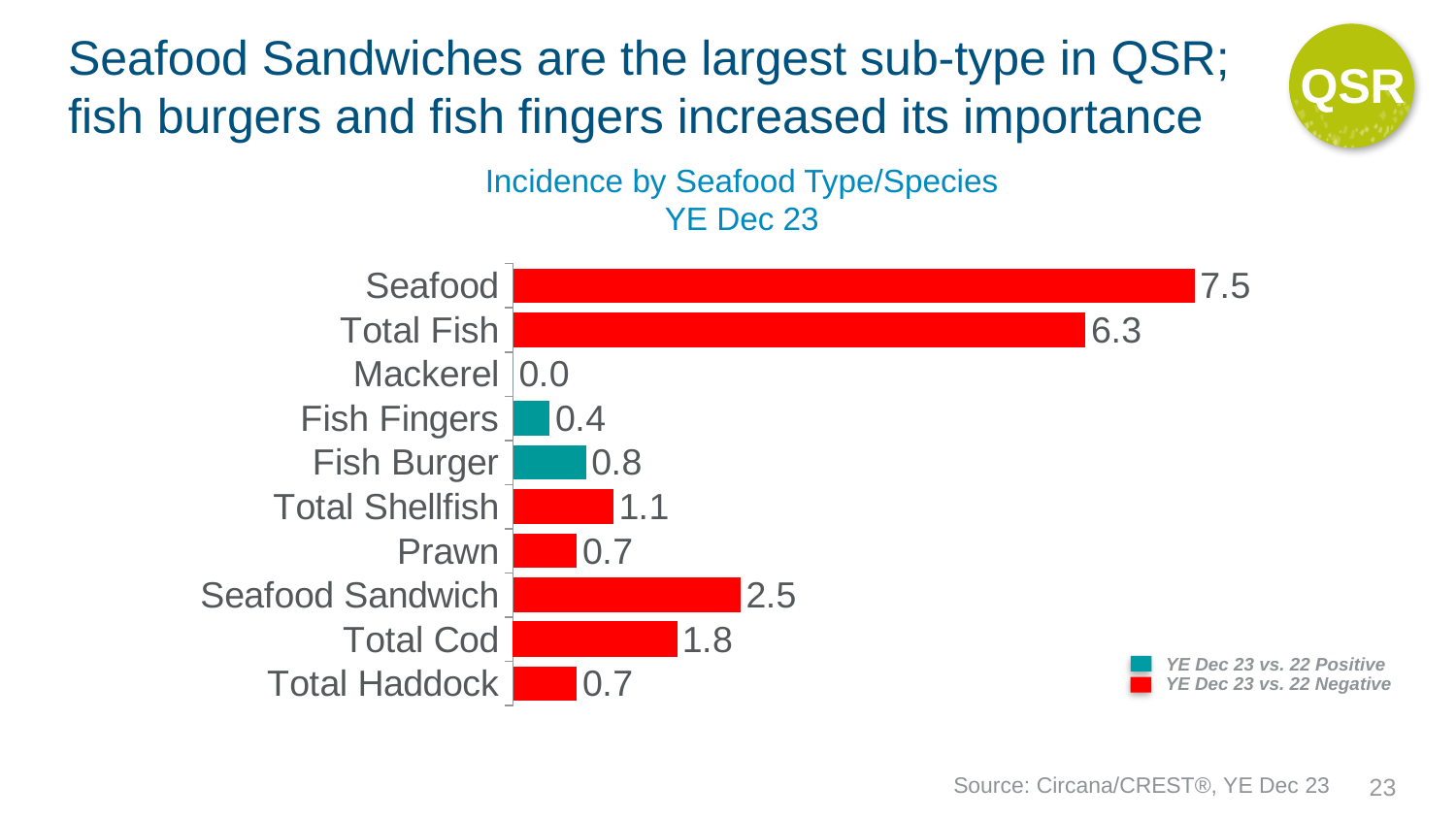
Which categories are shown in the colour indicating YE Dec 23 vs. 22 Positive? Fish Fingers and Fish Burger How many categories are shown in the chart? 10 What is the difference between the values for Seafood and Total Fish? 1.2 What kind of chart is shown on the slide? Bar chart Which category has the highest value? Seafood Which is larger, the value for Total Shellfish or the value for Fish Burger? Total Shellfish What is the value for Total Fish? 6.3 What is the value for Fish Burger? 0.8 What is the value for Mackerel? 0.0 What is the difference between the values for Seafood Sandwich and Total Cod? 0.7 What is the value for Seafood Sandwich? 2.5 Which category has the lowest value? Mackerel